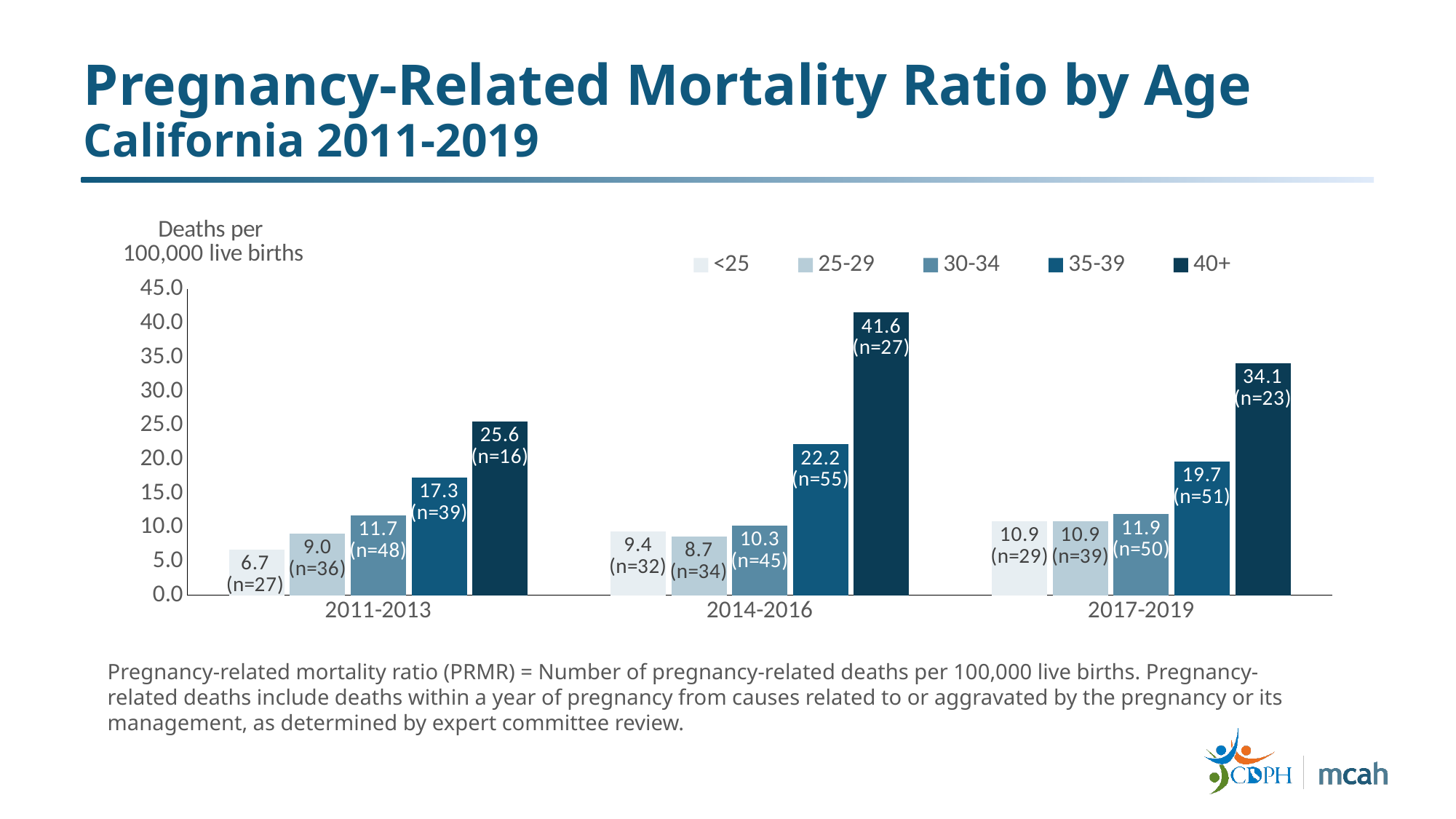
Which age group has the highest mortality ratio in 2017-2019? 40+ How many age groups does the legend list? 5 Which is larger: the 40+ value in 2011-2013 or the 40+ value in 2017-2019? 2017-2019 What is the value for the <25 age group in 2011-2013? 6.7 Which age group has the lowest mortality ratio in 2011-2013? <25 What is the difference between the 40+ and 35-39 values in 2014-2016? 19.4 Is the value for the 40+ age group in 2014-2016 greater or less than 40.0? greater What is the pregnancy-related mortality ratio for the 40+ age group in 2014-2016? 41.6 What is the value for the 35-39 age group in 2017-2019? 19.7 How many deaths (n) does the 30-34 bar for 2014-2016 represent? n=45 How many time periods are shown on the x axis? 3 What kind of chart is shown on the slide? Bar chart